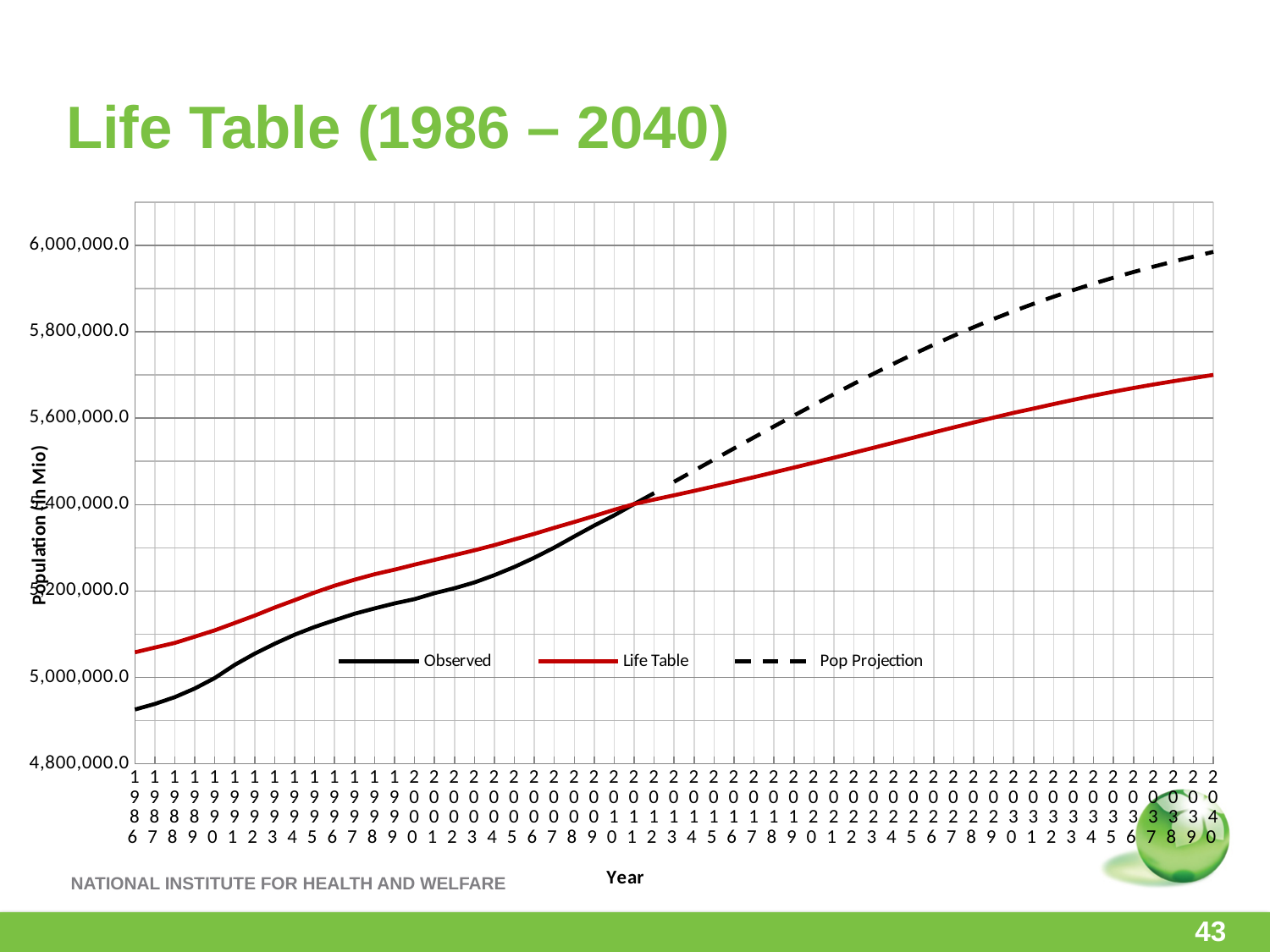
What are the three series named in the legend? Observed, Life Table, Pop Projection How many series does the legend list? 3 Is the Life Table value for 2040 greater or less than 5,800,000.0? less In 2040, which series has the higher value, Life Table or Pop Projection? Pop Projection What kind of chart is shown on the slide? line chart Is the Observed value for 1986 greater or less than 5,000,000.0? less Does the Observed series rise or fall over the years it covers? rise Does the Life Table series rise or fall from 1986 to 2040? rise Which series reaches the highest value on the chart? Pop Projection Is the Pop Projection value for 2040 greater or less than 5,800,000.0? greater What is the title of the y axis? Population (in Mio)